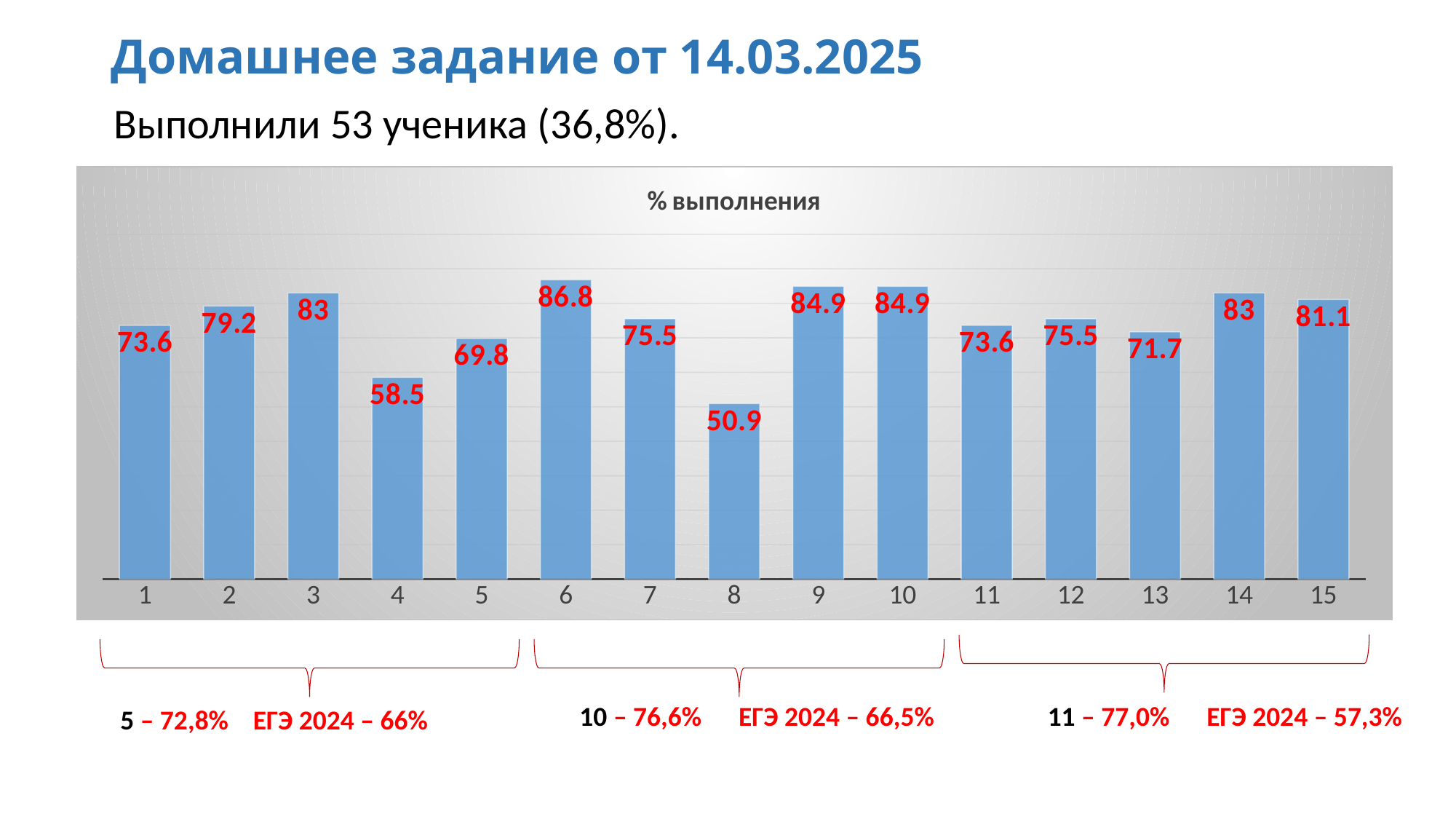
What is the difference between the values for task 2 and task 5? 9.4 What is the value for task 8 in the chart? 50.9 Which task has the highest value in the chart? 6 What is the value for task 1 in the chart? 73.6 Which task has the lowest value in the chart? 8 How many categories (tasks) are shown on the x axis of the chart? 15 What is the value for task 4 in the chart? 58.5 What type of chart is shown on the slide? bar chart What is the title of the chart? % выполнения What is the value for task 13 in the chart? 71.7 Which has a larger value, task 3 or task 4? task 3 What is the difference between the values for task 6 and task 8? 35.9